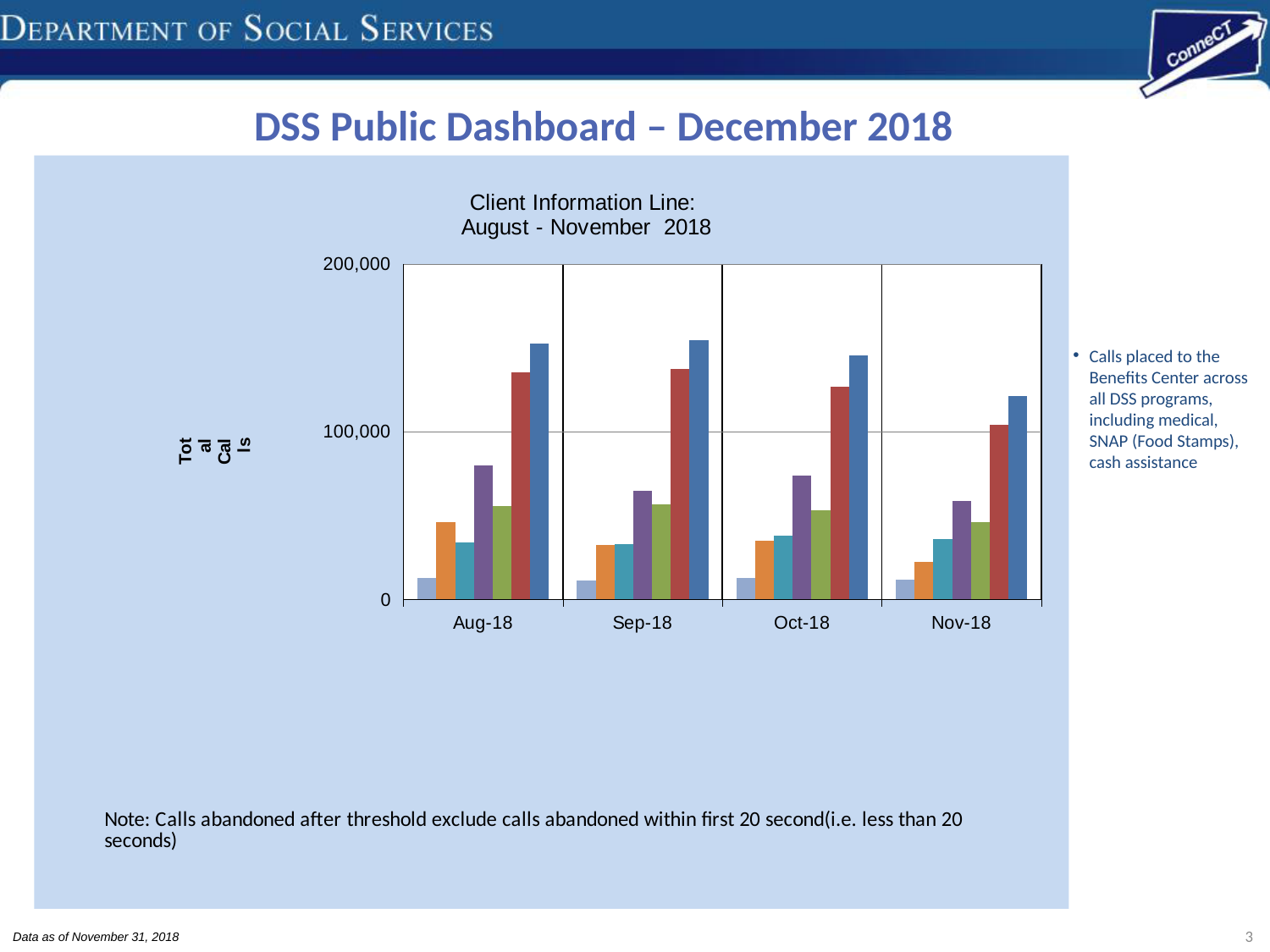
Is the tallest bar for Sep-18 greater or less than 100,000? greater Do the tallest (dark blue) bars rise or fall from Sep-18 to Nov-18? fall What is the label on the vertical axis of the chart? Total Calls Which is larger, the tallest bar for Sep-18 or the tallest bar for Nov-18? Sep-18 How many months (categories) are shown on the x axis of the chart? 4 What kind of chart is shown on the slide? bar chart Is the tallest bar for Oct-18 greater or less than 200,000? less Which month has the lowest tallest bar? Nov-18 Is the purple bar for Aug-18 greater or less than 100,000? less What is the title of the chart? Client Information Line: August - November 2018